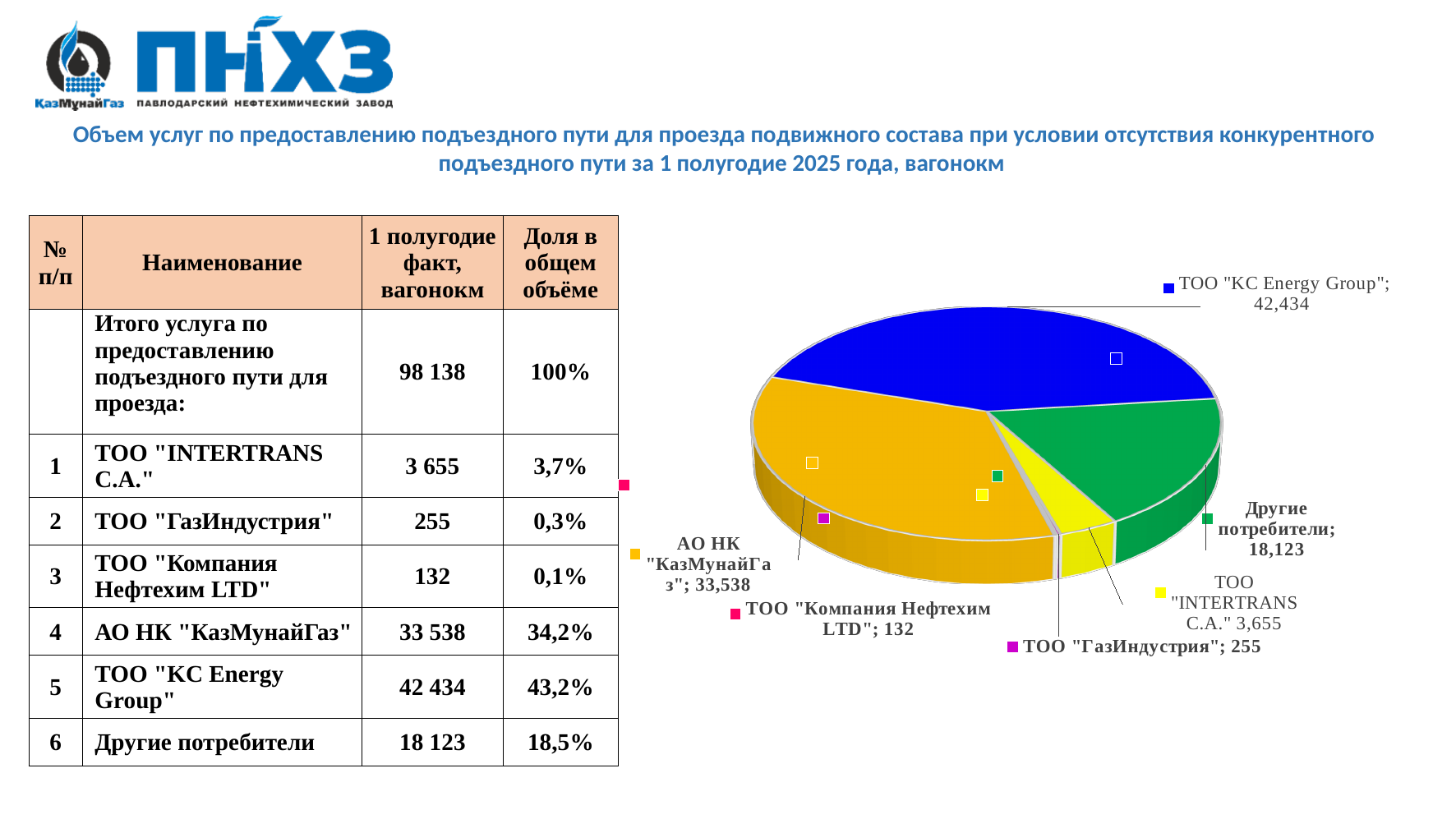
What is the value shown for Другие потребители in the pie chart? 18,123 Which category has the smallest slice in the pie chart? ТОО "Компания Нефтехим LTD" What is the difference between the values for ТОО "INTERTRANS C.A." and ТОО "ГазИндустрия" in the pie chart? 3,400 What is the value shown for ТОО "KC Energy Group" in the pie chart? 42,434 What colour is the slice for Другие потребители in the pie chart? green What is the value shown for АО НК "КазМунайГаз" in the pie chart? 33,538 What share of the total does ТОО "KC Energy Group" account for, according to the table next to the pie chart? 43,2% What type of chart is shown on the slide? pie chart Which is larger in the pie chart: АО НК "КазМунайГаз" or Другие потребители? АО НК "КазМунайГаз" Which category has the largest slice in the pie chart? ТОО "KC Energy Group" What is the value shown for ТОО "ГазИндустрия" in the pie chart? 255 How many slices does the pie chart have? 6